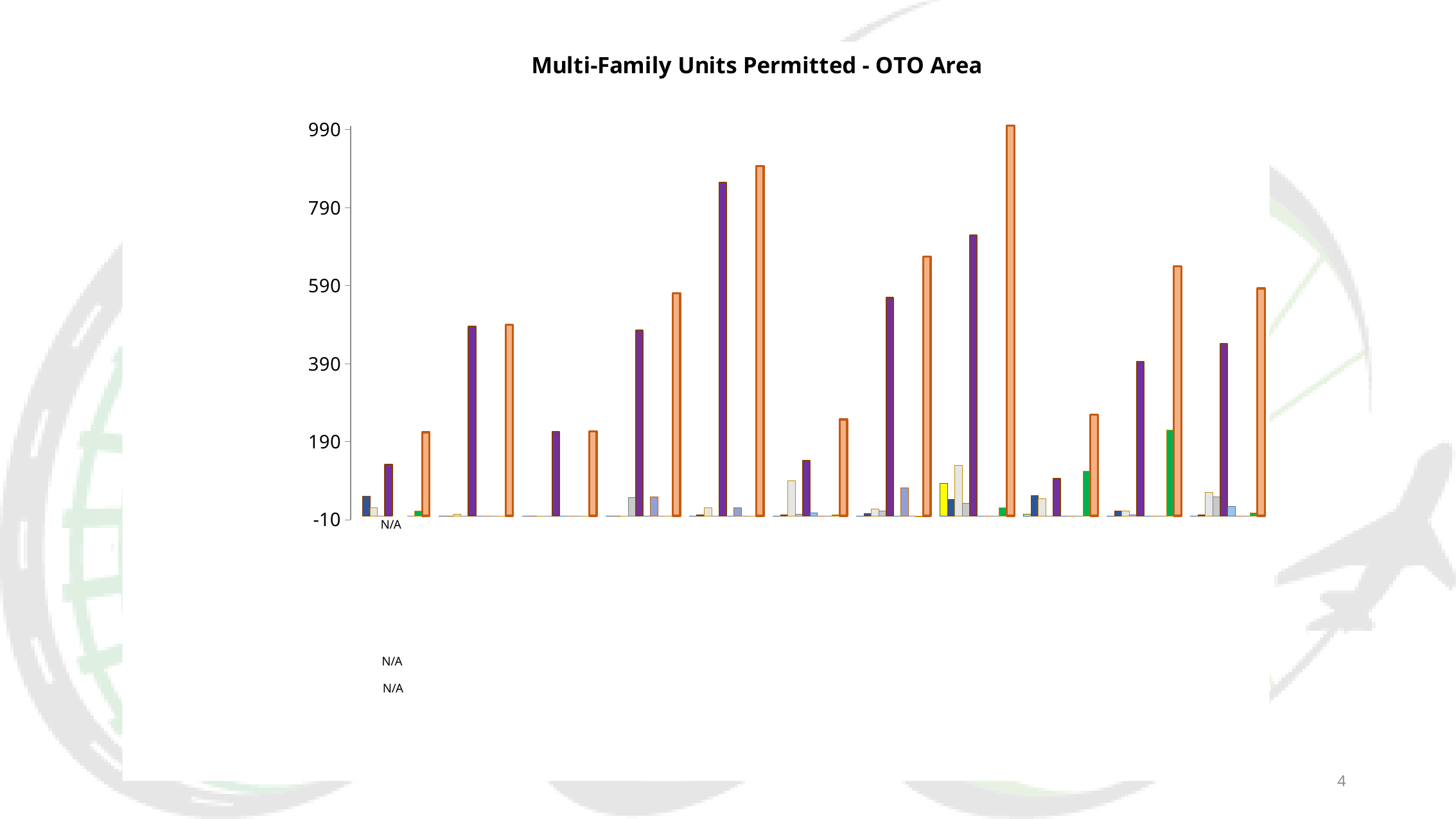
What is the title of the chart? Multi-Family Units Permitted - OTO Area What kind of chart is shown on the slide? bar chart What is the highest value labelled on the vertical axis of the chart? 990 Is the value of the tallest bar in the chart greater or less than 990? greater Is the value of the tallest bar in the chart greater or less than 790? greater